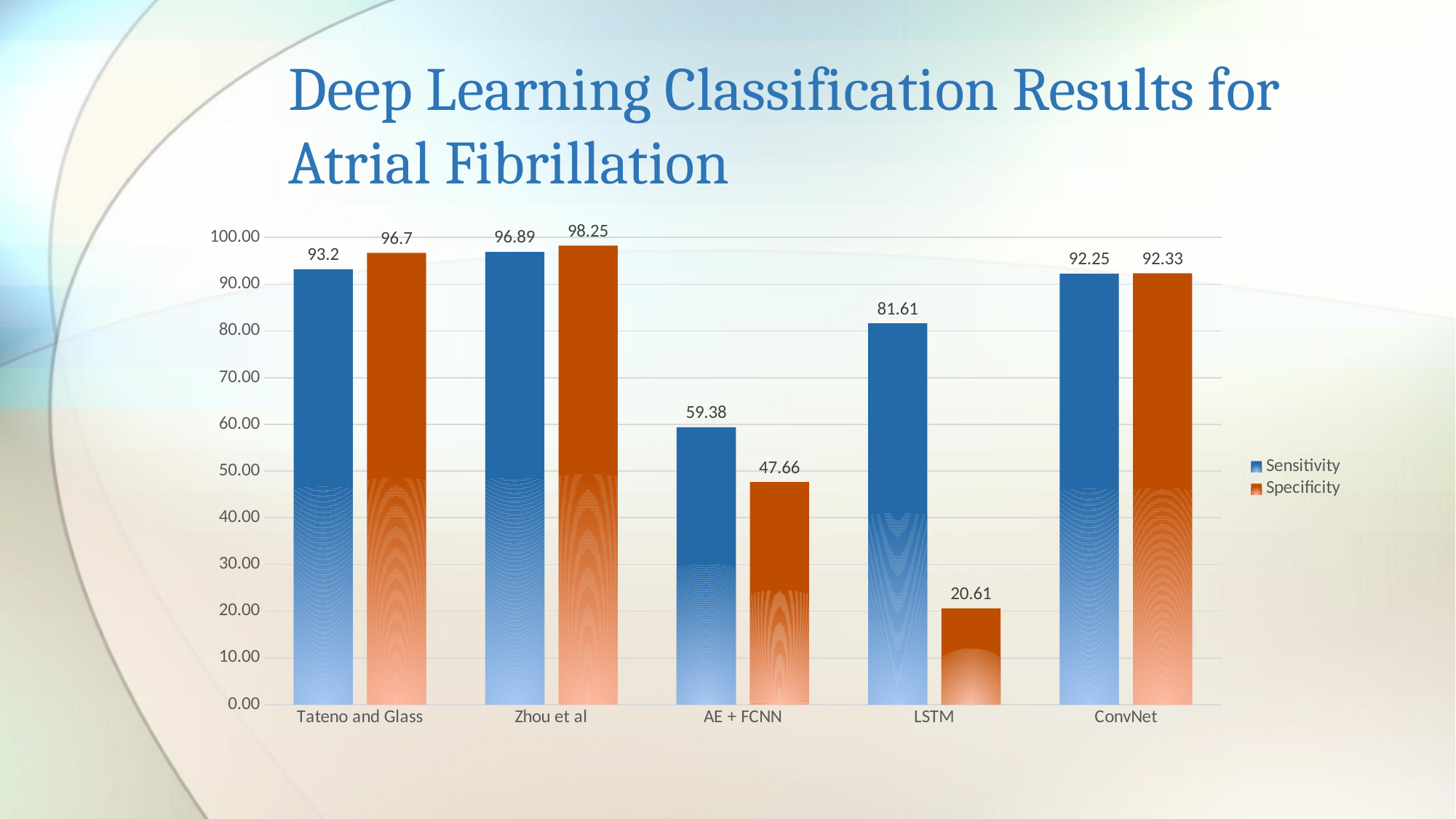
What colour represents the Specificity series? orange What is the Specificity value for AE + FCNN? 47.66 How many categories are shown on the x axis? 5 Which category has the lowest Sensitivity? AE + FCNN Which is larger for Tateno and Glass, Sensitivity or Specificity? Specificity How many series does the legend list? 2 What is the Sensitivity value for LSTM? 81.61 What kind of chart is shown on the slide? bar chart What is the Sensitivity value for Tateno and Glass? 93.2 Which category has the highest Specificity? Zhou et al Is the Specificity value for LSTM greater or less than 30.00? less What is the difference between the Sensitivity and Specificity values for LSTM? 61